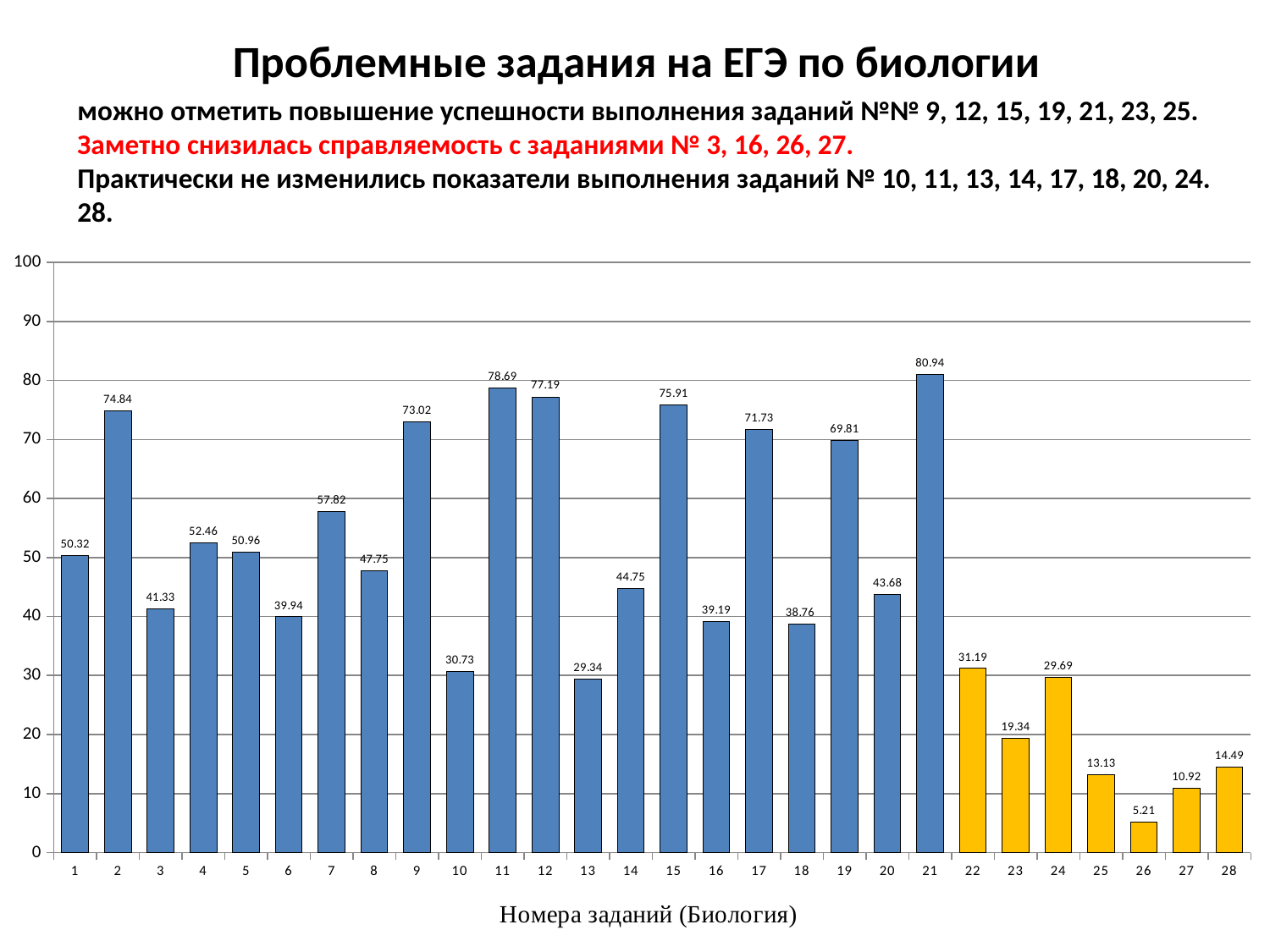
What kind of chart is shown on the slide? Bar chart How many task numbers are shown on the x axis? 28 What is the value for task 13? 29.34 What is the value for task 26? 5.21 What is the x-axis title of the chart? Номера заданий (Биология) What is the difference between the values for task 11 and task 12? 1.50 Is the value for task 17 greater or less than 70? greater Which has a larger value, task 2 or task 9? Task 2 Which task number has the highest value? 21 What is the value for task 21? 80.94 Which task number has the lowest value? 26